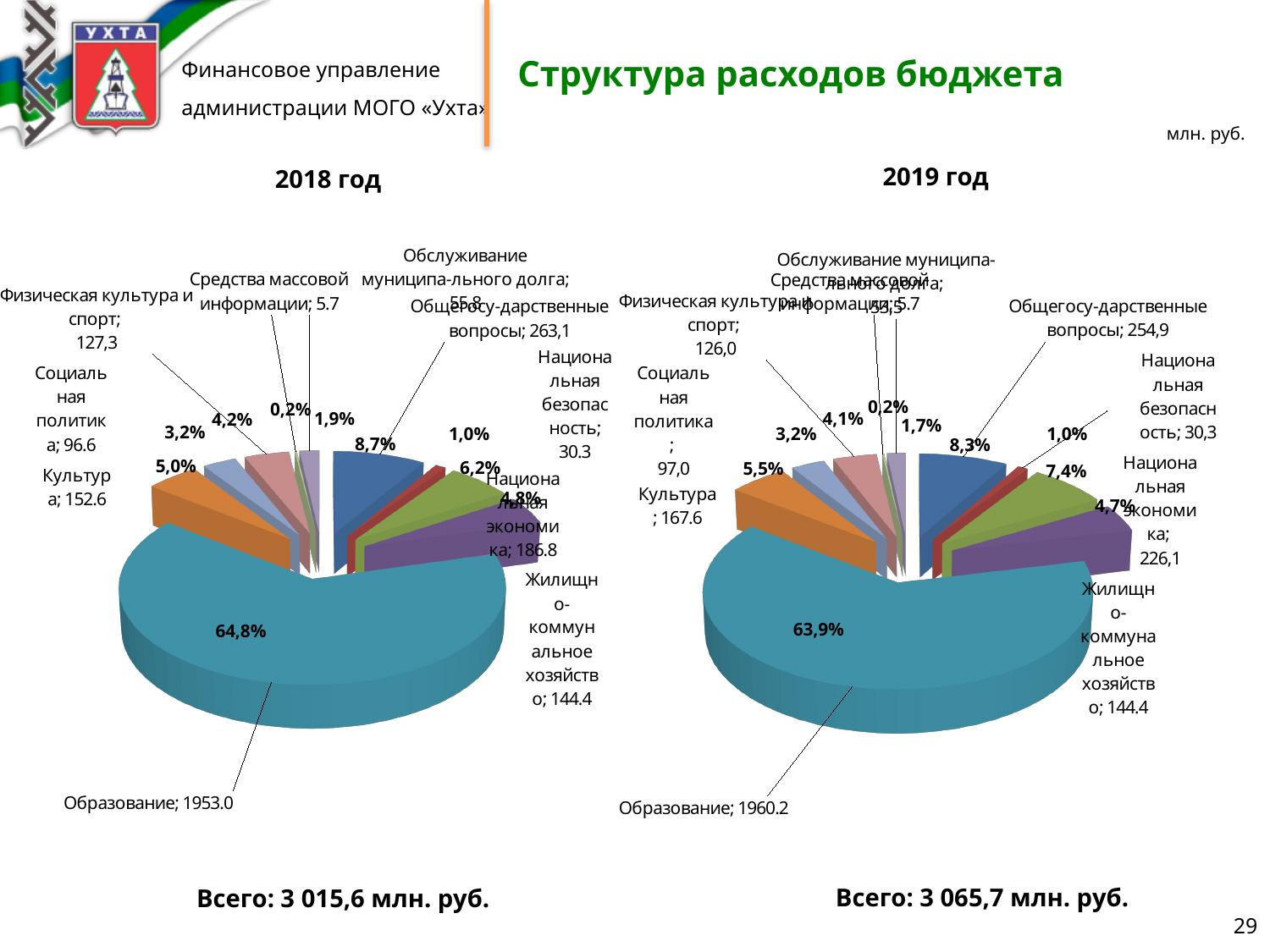
In the 2019 год chart, what share of the pie does Общегосу-дарственные вопросы take? 8,3% In the 2019 год chart, what is the difference between the values for Культура and Социальная политика? 70.6 In the 2019 год chart, what is the value for Национальная экономика? 226,1 What total is stated below the 2018 год chart? 3 015,6 млн. руб. In the 2018 год chart, what share of the pie does Образование take? 64,8% In the 2019 год chart, what is the value for Образование? 1960.2 What type of chart is used for the 2018 год chart? pie chart In the 2019 год chart, which category has the smallest slice? Средства массовой информации In the 2018 год chart, what is the value for Образование? 1953.0 In the 2018 год chart, which is larger: Культура or Физическая культура и спорт? Культура In the 2018 год chart, which category has the largest slice? Образование How many categories are shown in the 2019 год chart? 10